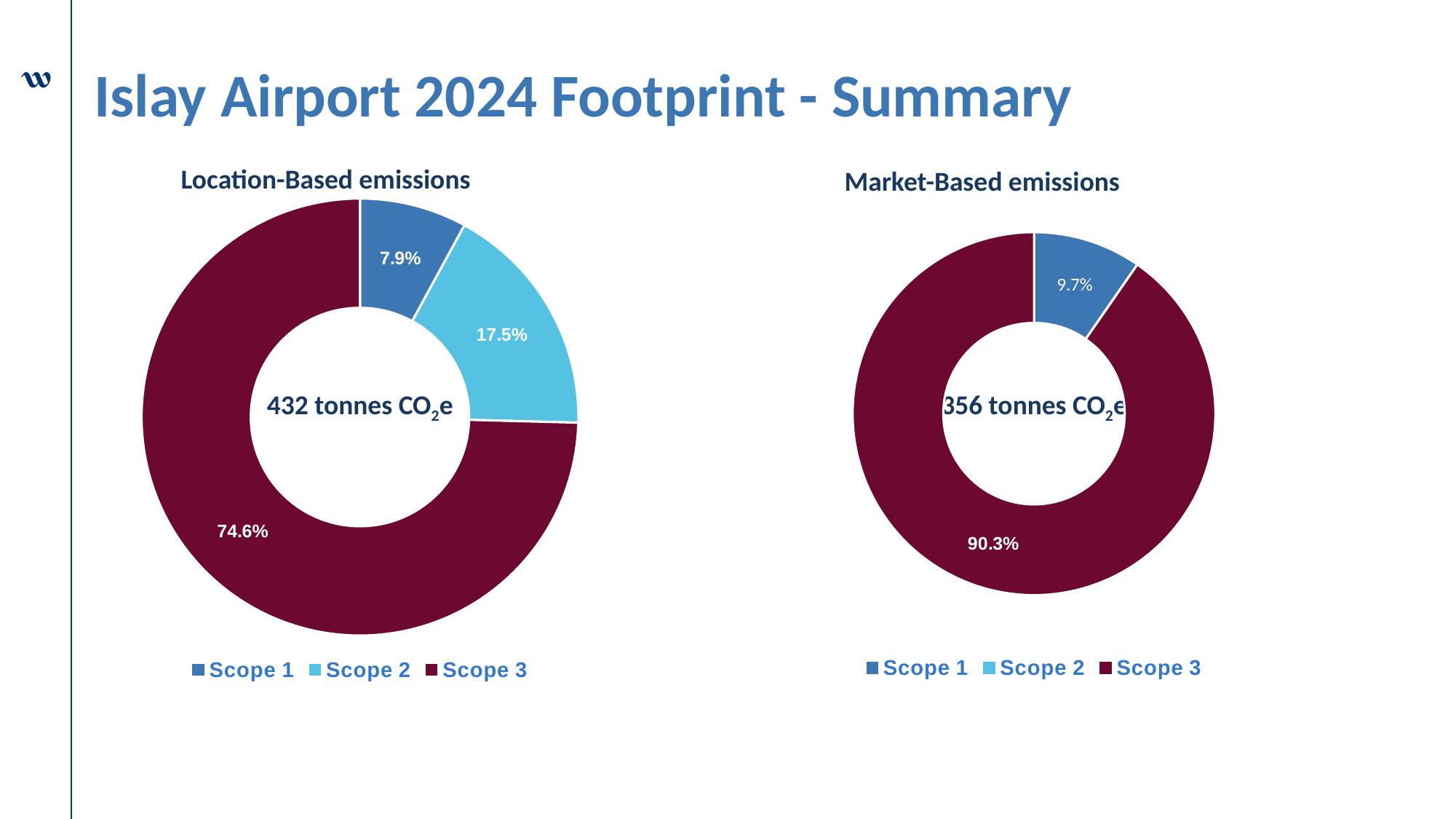
In the Market-Based emissions chart, what share of emissions is Scope 3? 90.3% In the Location-Based emissions chart, what share of emissions is Scope 2? 17.5% In the Location-Based emissions chart, which scope has the smallest share? Scope 1 In the Market-Based emissions chart, what is the difference in percentage points between Scope 3 and Scope 1? 80.6 What total emissions figure is shown in the centre of the Location-Based emissions chart? 432 tonnes CO2e In the Location-Based emissions chart, what share of emissions is Scope 1? 7.9% In the Location-Based emissions chart, which scope has the largest share? Scope 3 In the Market-Based emissions chart, what share of emissions is Scope 1? 9.7% What total emissions figure is shown in the centre of the Market-Based emissions chart? 356 tonnes CO2e In the Location-Based emissions chart, what is the difference in percentage points between Scope 2 and Scope 1? 9.6 How many entries does the legend of the Location-Based emissions chart list? 3 Which chart shows a larger share for Scope 1, Location-Based emissions or Market-Based emissions? Market-Based emissions